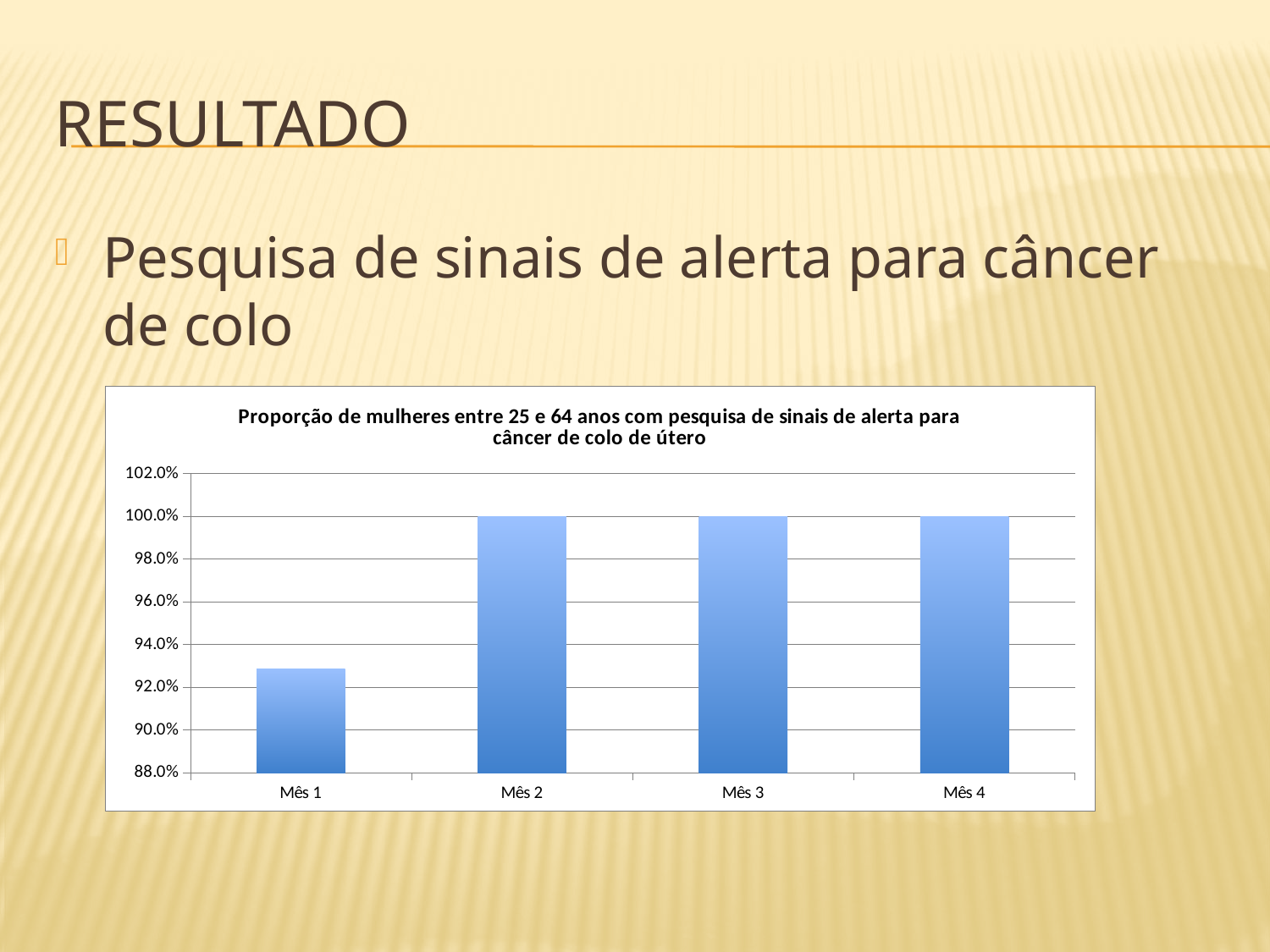
What is the value for Mês 4? 100.0% What is the difference between the values for Mês 2 and Mês 4? 0.0% How many categories (months) are shown on the x axis of the chart? 4 What is the title of the chart? Proporção de mulheres entre 25 e 64 anos com pesquisa de sinais de alerta para câncer de colo de útero Is the value for Mês 1 greater or less than 92.0%? greater Which month has the lowest value? Mês 1 Does the value rise or fall from Mês 1 to Mês 2? rise What is the value for Mês 3? 100.0% What kind of chart is shown on the slide? bar chart Which is larger, the value for Mês 1 or the value for Mês 2? Mês 2 What is the value for Mês 2? 100.0% Is the value for Mês 1 greater or less than 94.0%? less